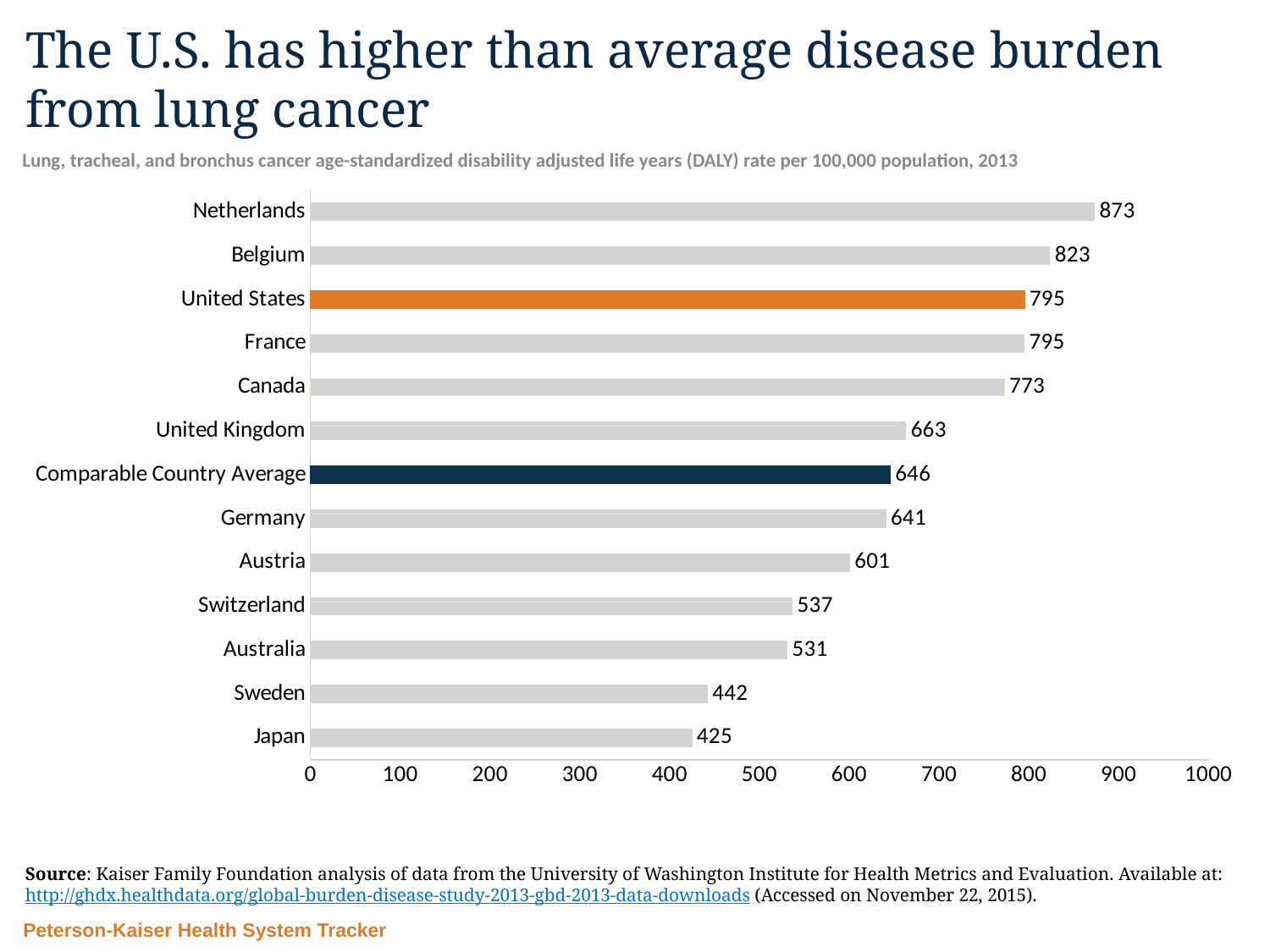
What is the DALY rate for the United States? 795 Which bar is coloured orange? United States Which country has the highest DALY rate on the chart? Netherlands Which has a higher value, Canada or the United Kingdom? Canada What is the value shown for the Comparable Country Average? 646 What is the difference between the Netherlands and Belgium values? 50 How many bars are shown on the chart? 13 Which country has the lowest DALY rate on the chart? Japan What is the value for Japan? 425 Is the value for Sweden greater or less than 500? less What kind of chart is shown on the slide? Bar chart What is the difference between the United States value and the Comparable Country Average? 149